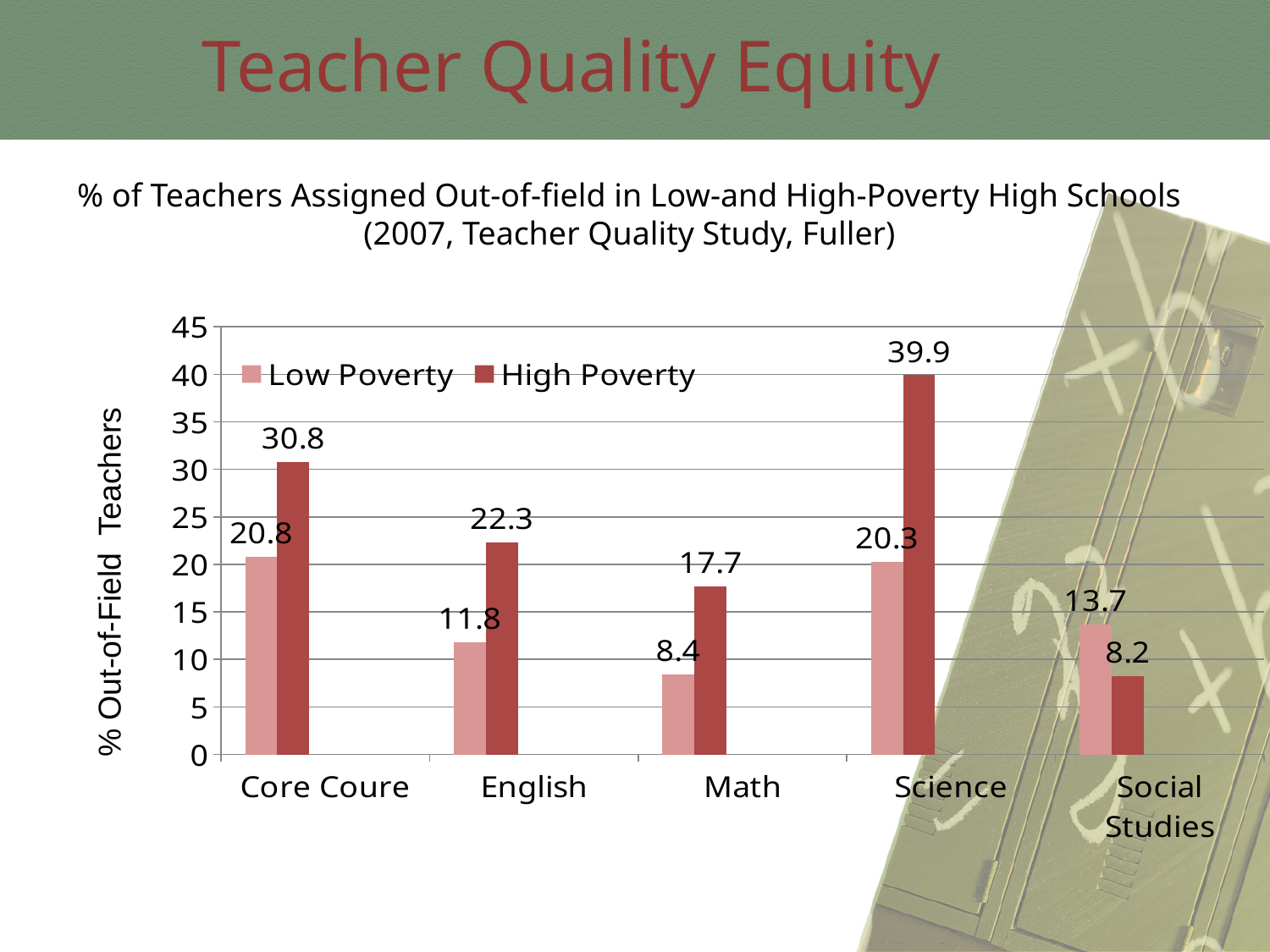
How many categories are shown on the x axis? 5 What is the difference between the High Poverty and Low Poverty values for Core Coure? 10 What is the difference between the High Poverty and Low Poverty values for Science? 19.6 How many series does the legend list? 2 What kind of chart is shown on the slide? bar chart What is the High Poverty value for Science? 39.9 What is the Low Poverty value for Math? 8.4 Which category has the lowest Low Poverty value? Math What is the Low Poverty value for Social Studies? 13.7 Is the High Poverty value for English greater or less than 20? greater Which category has the highest High Poverty value? Science For Social Studies, which is larger: the Low Poverty value or the High Poverty value? Low Poverty